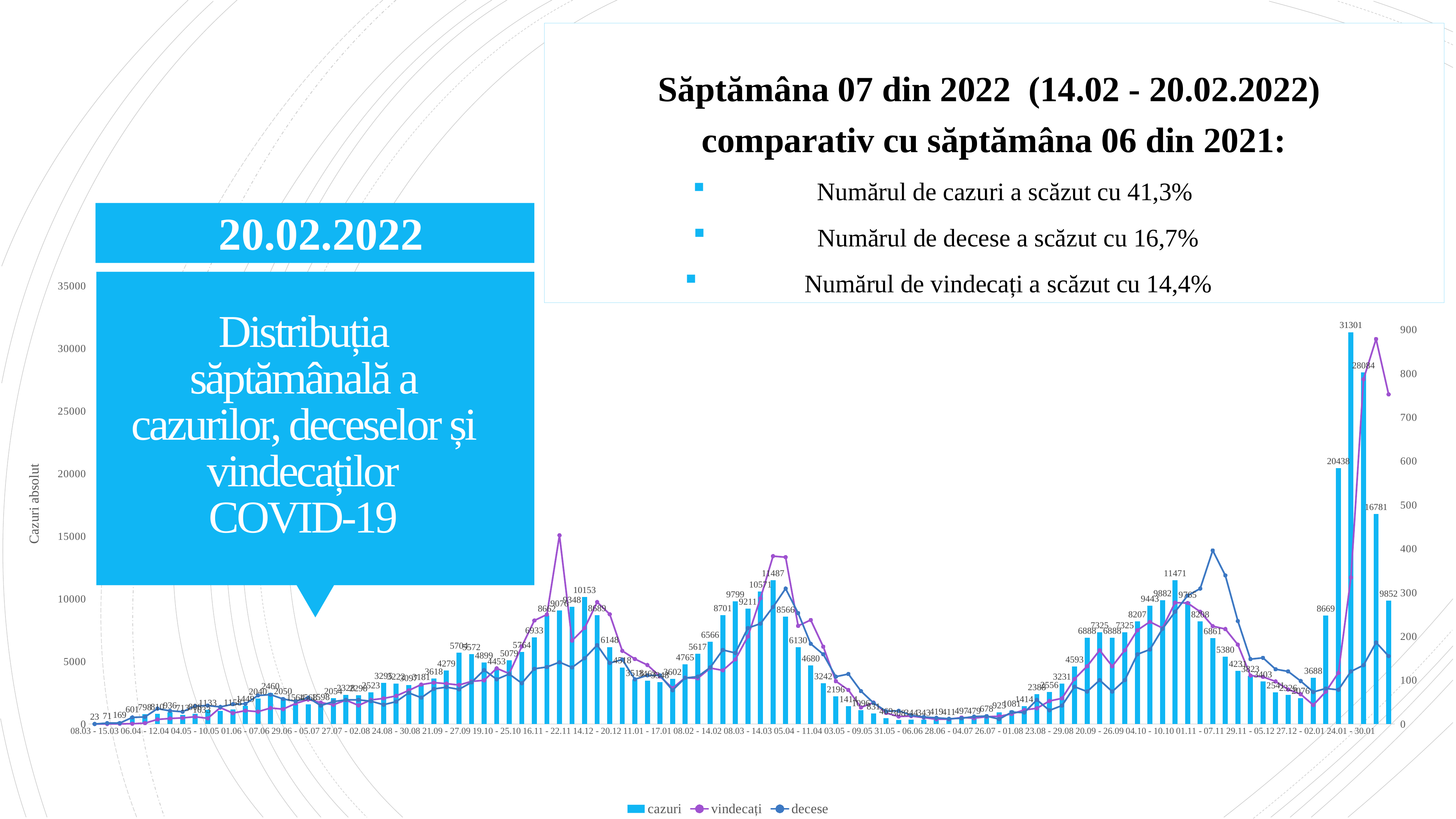
What is the value of the first (leftmost) cazuri bar? 23 What is the value of the last (rightmost) cazuri bar? 9852 What is the difference between the two highest cazuri bars, 31301 and 28084? 3217 What kind of chart is shown on the slide? A combination bar and line chart How many series does the chart legend list? 3 Is the peak of the decese line greater or less than 300 on the right-hand axis? greater What is the highest value labelled on the cazuri bars? 31301 Which is larger among the cazuri bars labelled 20438 and 16781? 20438 Do the cazuri bars rise or fall over the last four bars of the chart (from 31301 onward)? fall What is the lowest value labelled on the cazuri bars? 23 Which series is plotted as bars in the chart? cazuri